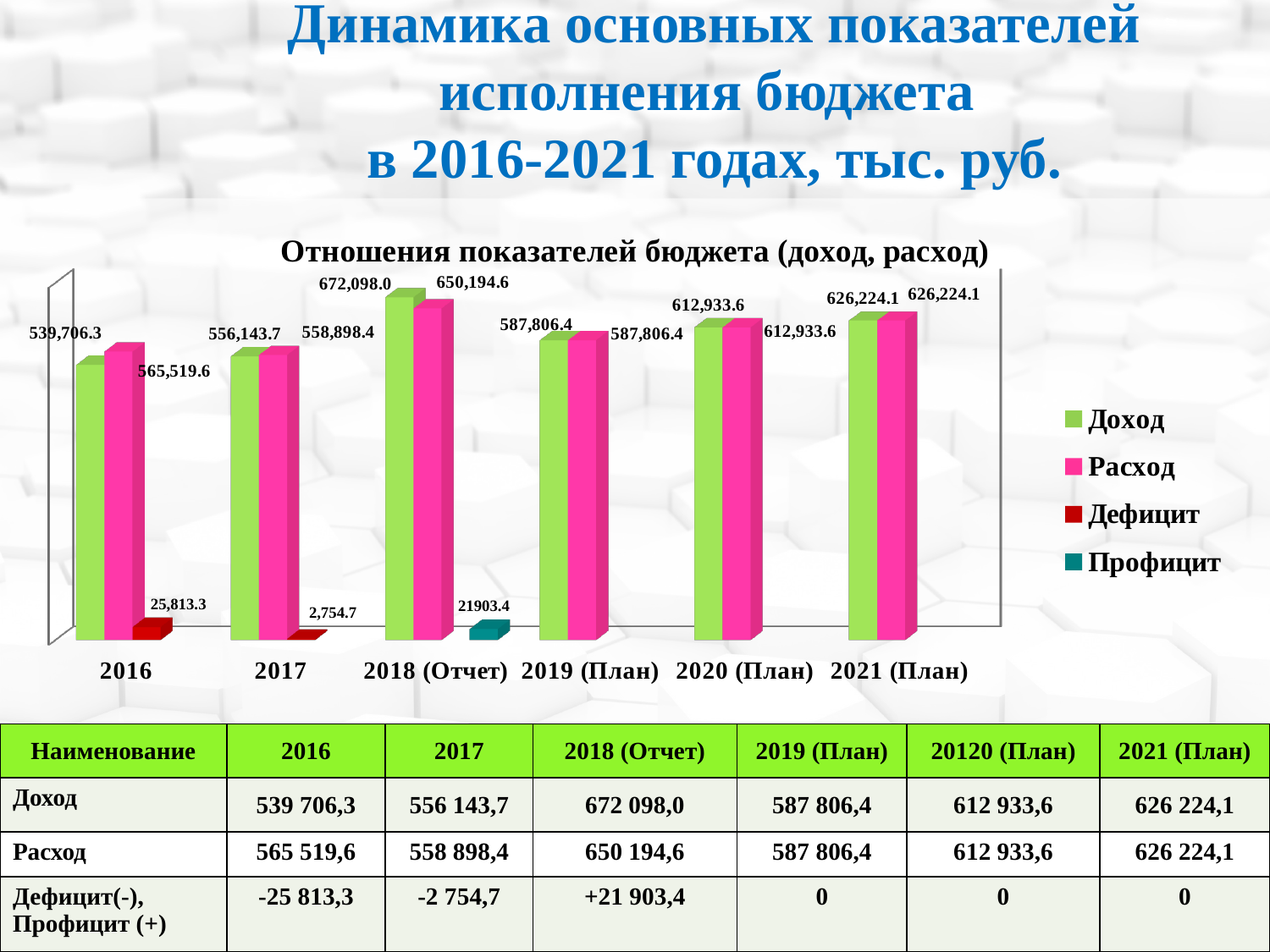
What is the value of Расход for 2018 (Отчет) in the chart? 650,194.6 What type of chart is shown on the slide? Bar chart For 2016, which is larger in the chart: Доход or Расход? Расход What is the value of Доход for 2016 in the chart? 539,706.3 How many year categories are shown on the x axis of the chart? 6 What is the difference between Доход and Расход for 2018 (Отчет) in the chart? 21,903.4 What is the title of the chart on the slide? Отношения показателей бюджета (доход, расход) Which year has the highest Доход value in the chart? 2018 (Отчет) What is the value of Профицит shown for 2018 (Отчет) in the chart? 21903.4 What is the value of Дефицит for 2017 in the chart? 2,754.7 How many series does the chart legend list? 4 Which year has the lowest Расход value in the chart? 2017